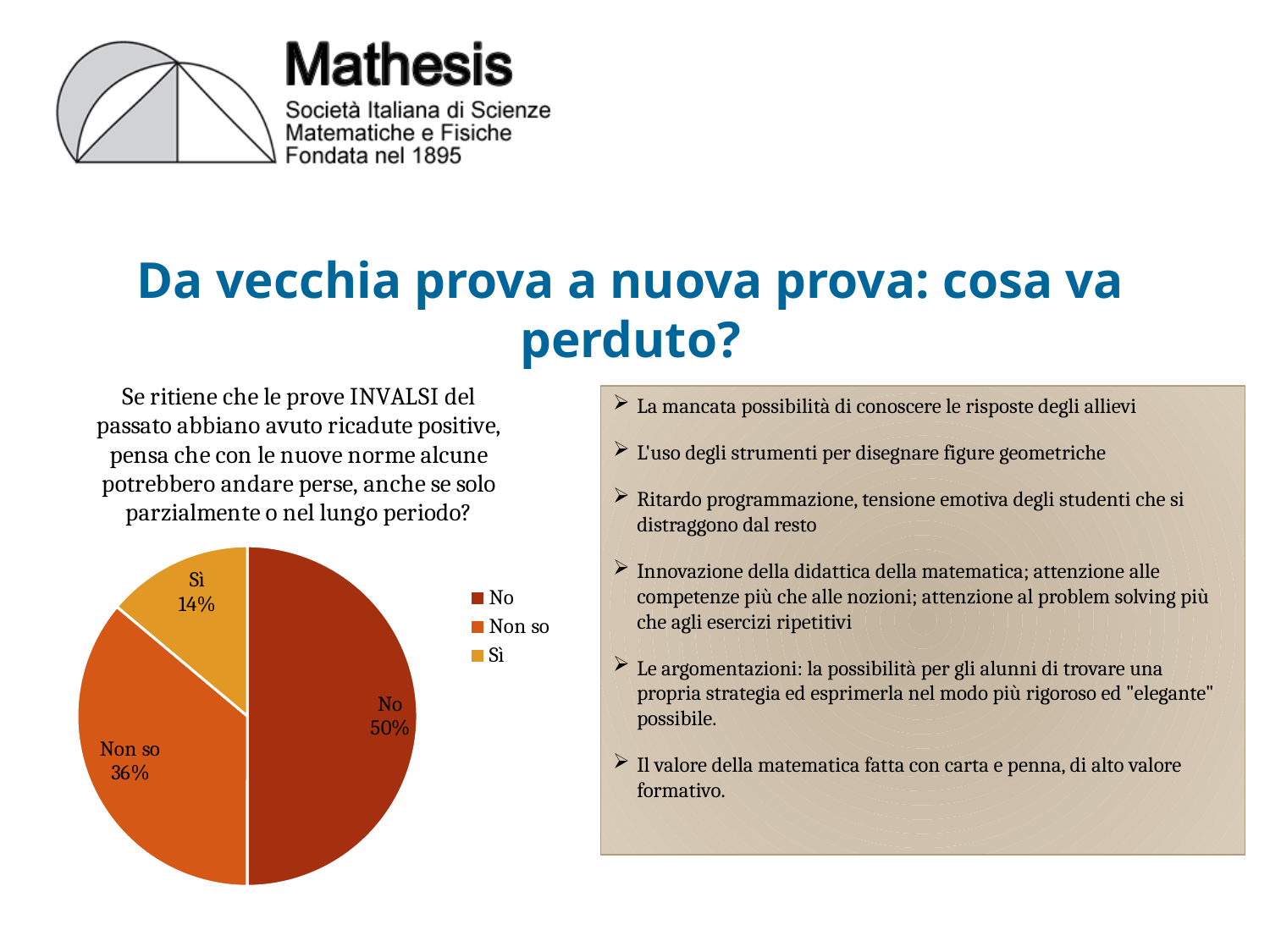
What percentage of respondents answered "Sì"? 14% Which response has the smallest share of the pie? Sì What percentage of respondents answered "No"? 50% How many entries does the legend list? 3 Which response has the largest share of the pie? No How many slices does the pie chart have? 3 What kind of chart is shown on the slide? pie chart What percentage of respondents answered "Non so"? 36% What colour is the "Sì" slice in the pie chart? yellow-orange What is the difference in percentage points between the "No" and "Sì" slices? 36 What is the difference in percentage points between the "Non so" and "Sì" slices? 22 Which is larger, the "Non so" slice or the "Sì" slice? Non so